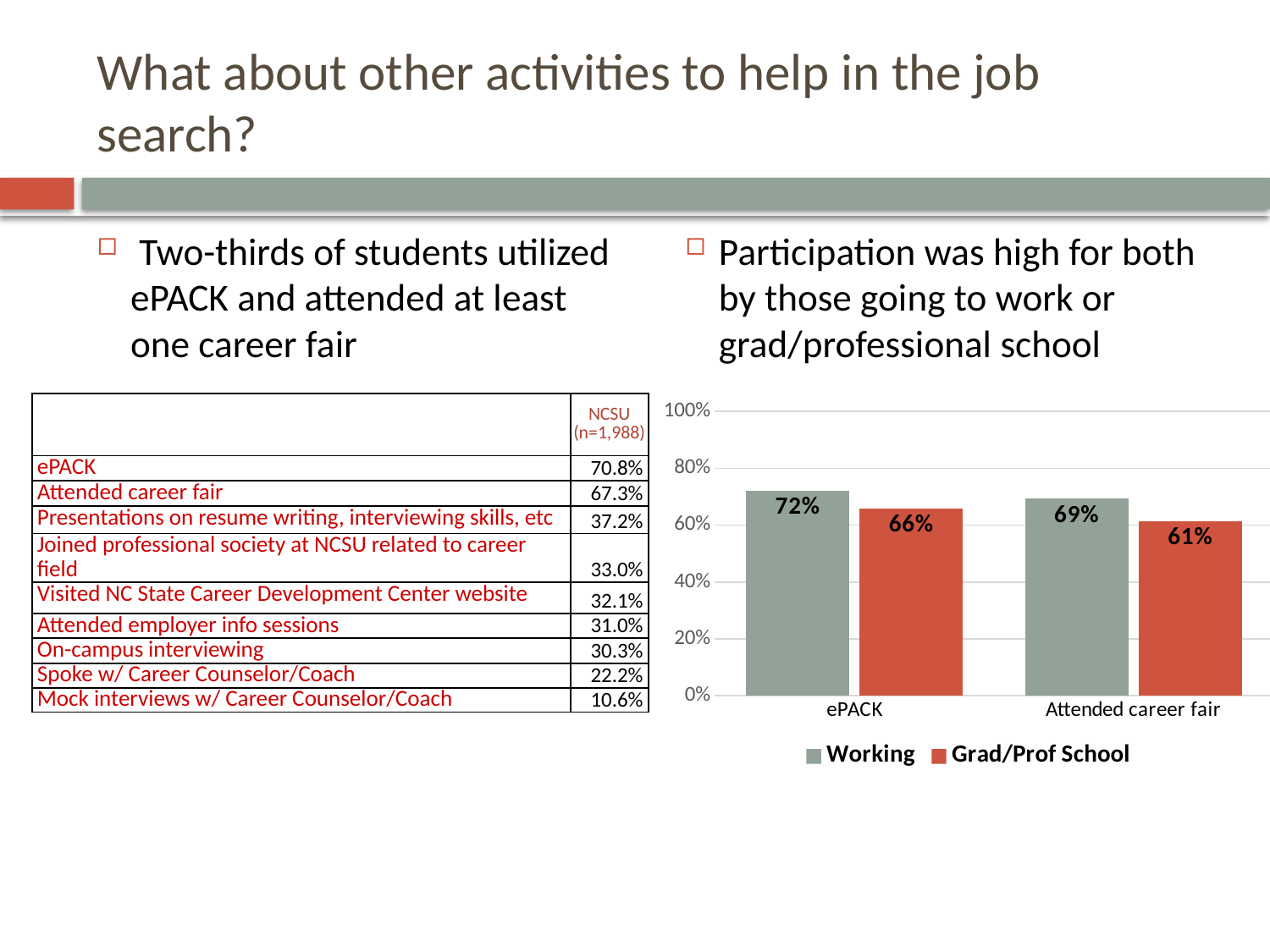
Which bar in the chart has the highest value? Working, ePACK What kind of chart is shown on the slide? Bar chart Which is larger for Attended career fair: Working or Grad/Prof School? Working What is the value for Working in the Attended career fair category? 69% Which bar in the chart has the lowest value? Grad/Prof School, Attended career fair What is the difference between the Working and Grad/Prof School values for ePACK? 6% What is the value for Working in the ePACK category? 72% What is the difference between the Working and Grad/Prof School values for Attended career fair? 8% How many series does the chart legend list? 2 How many categories are shown on the x axis of the chart? 2 What is the value for Grad/Prof School in the Attended career fair category? 61% What is the value for Grad/Prof School in the ePACK category? 66%